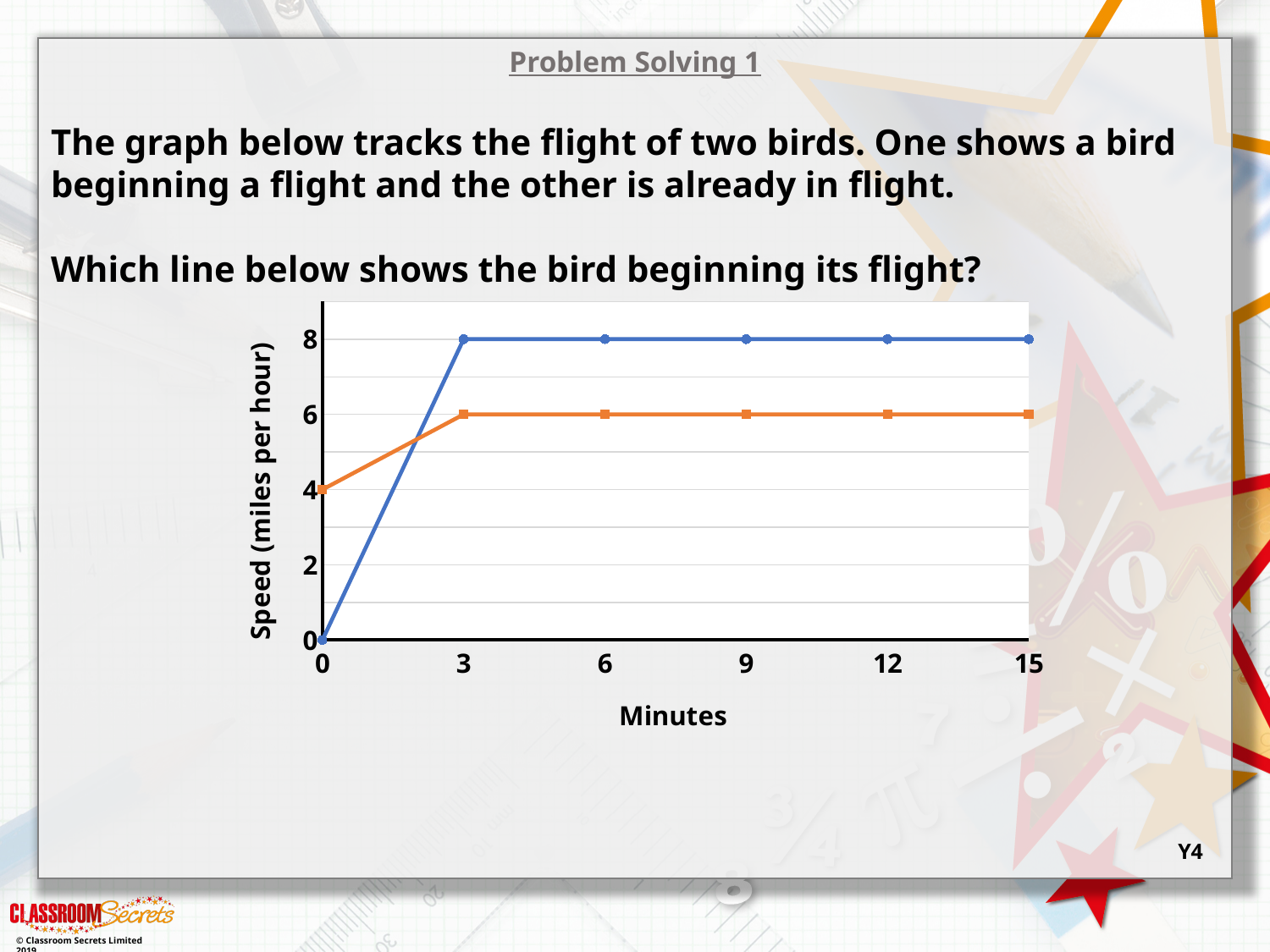
What is the label of the x axis? Minutes What is the label of the y axis? Speed (miles per hour) How does the blue line change between 3 minutes and 15 minutes? it stays flat What kind of chart is shown on the slide? line chart What is the speed of the orange line at 15 minutes? 6 What is the speed of the blue line at 3 minutes? 8 Which line has the higher speed at 0 minutes, the blue line or the orange line? orange line What is the speed of the orange line at 0 minutes? 4 Which line has the higher speed at 9 minutes, the blue line or the orange line? blue line What is the speed of the blue line at 0 minutes? 0 How many lines are plotted on the chart? 2 What is the difference in speed between the blue line and the orange line at 12 minutes? 2